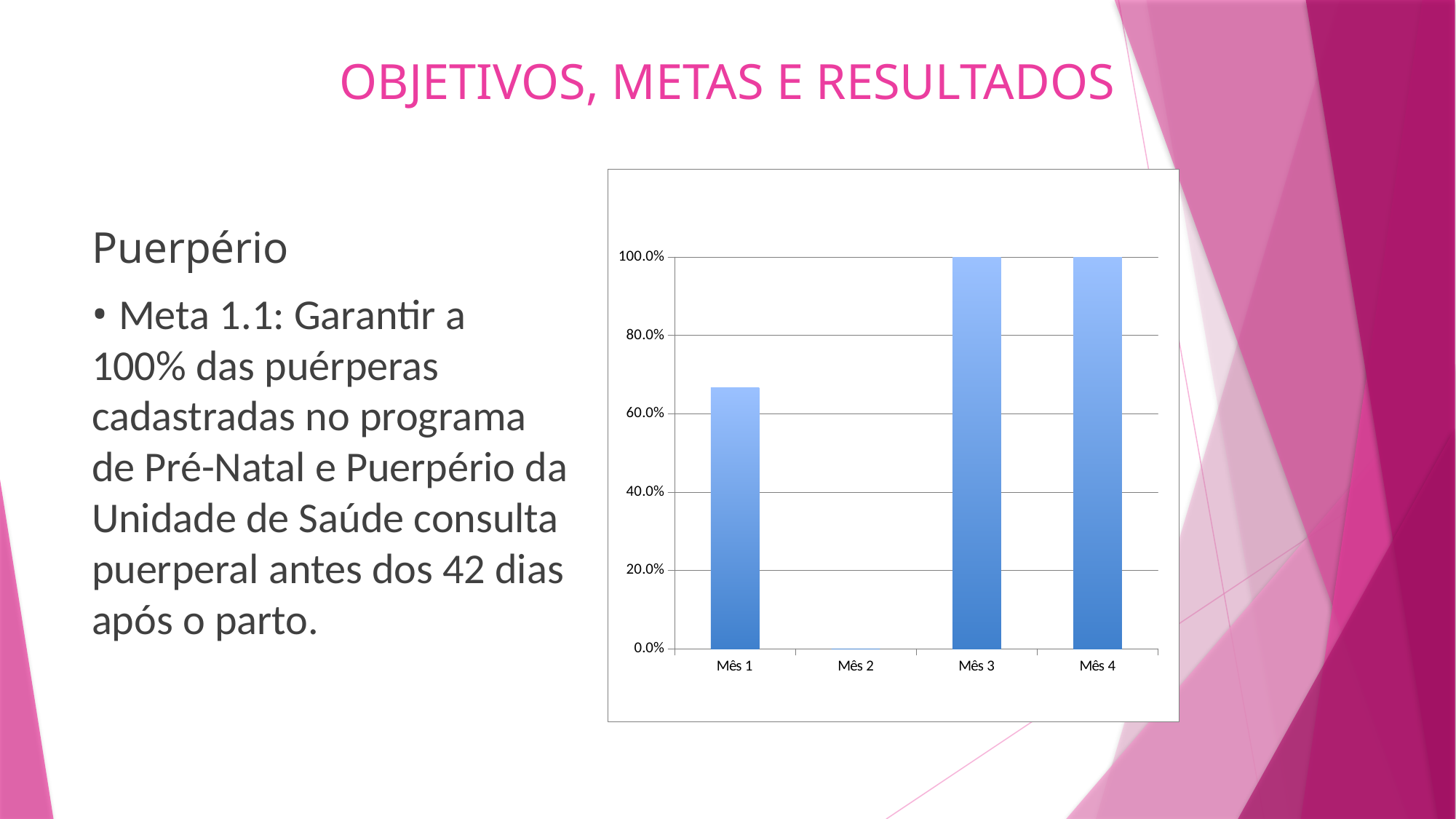
Is the value for Mês 1 greater or less than 60.0%? greater What is the value for Mês 3 in the chart? 100.0% What is the highest tick value shown on the y axis of the chart? 100.0% What is the value for Mês 4 in the chart? 100.0% Is the value for Mês 1 greater or less than 80.0%? less Does the value rise or fall from Mês 1 to Mês 3? rise Which category has no visible bar in the chart? Mês 2 How many categories are shown on the x axis of the chart? 4 What kind of chart is shown on the slide? bar chart Which is larger, the value for Mês 4 or the value for Mês 1? Mês 4 What is the difference between the values for Mês 3 and Mês 4? 0.0% Which is larger, the value for Mês 1 or the value for Mês 3? Mês 3